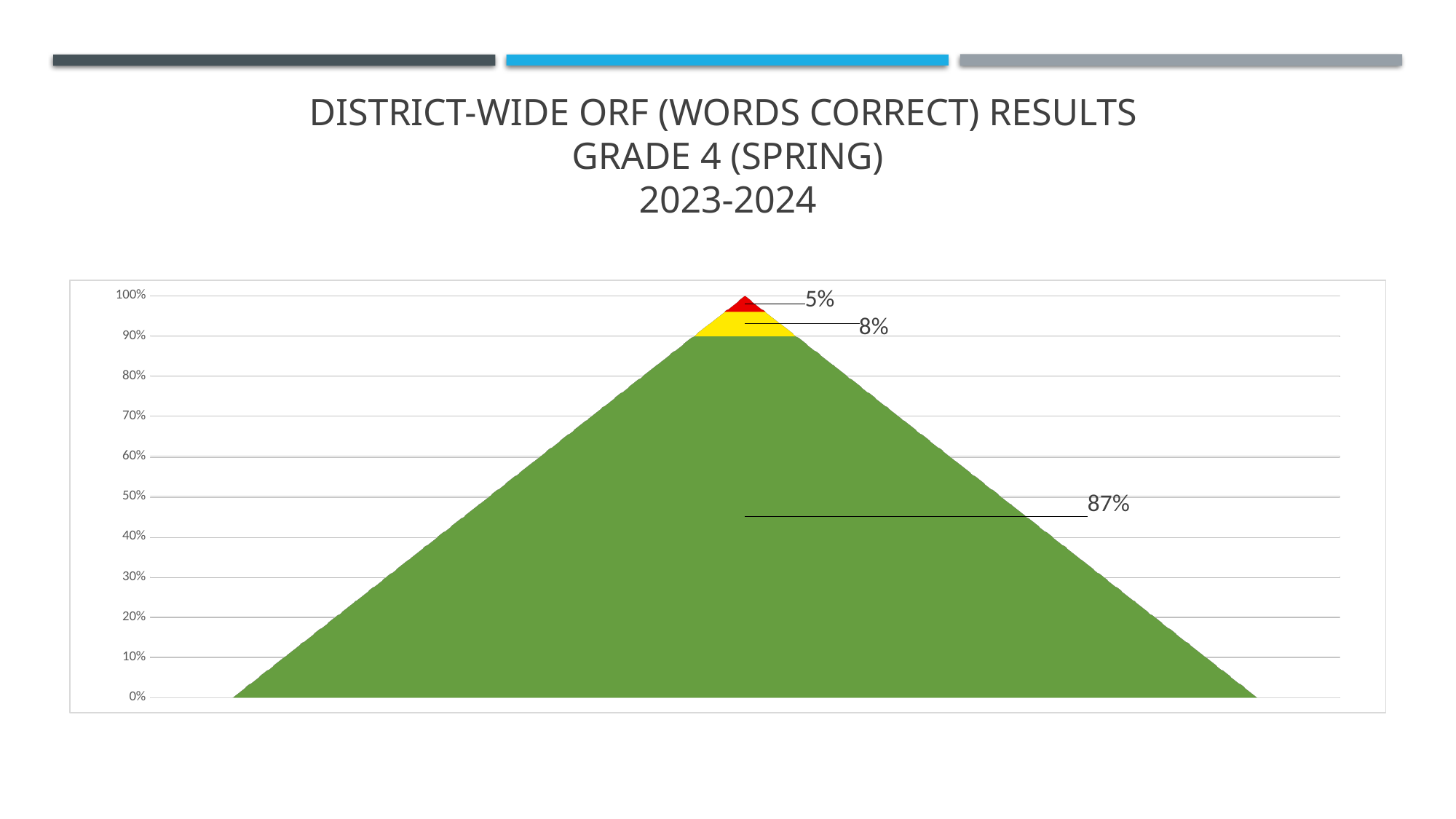
What value is labelled on the red segment at the top of the chart? 5% What is the total of the three labelled segments in the chart? 100% What is the difference between the green segment's value and the yellow segment's value? 79% How many labelled segments does the chart contain? 3 What value is labelled on the yellow segment of the chart? 8% What is the title of the slide containing the chart? District-Wide ORF (Words Correct) Results Grade 4 (Spring) 2023-2024 What is the difference between the yellow segment's value and the red segment's value? 3% Which coloured segment has the largest value? green What value is labelled on the green segment of the chart? 87% Which coloured segment has the smallest value? red Is the value for the green segment greater or less than 80%? greater Which is larger, the yellow segment's value or the red segment's value? yellow